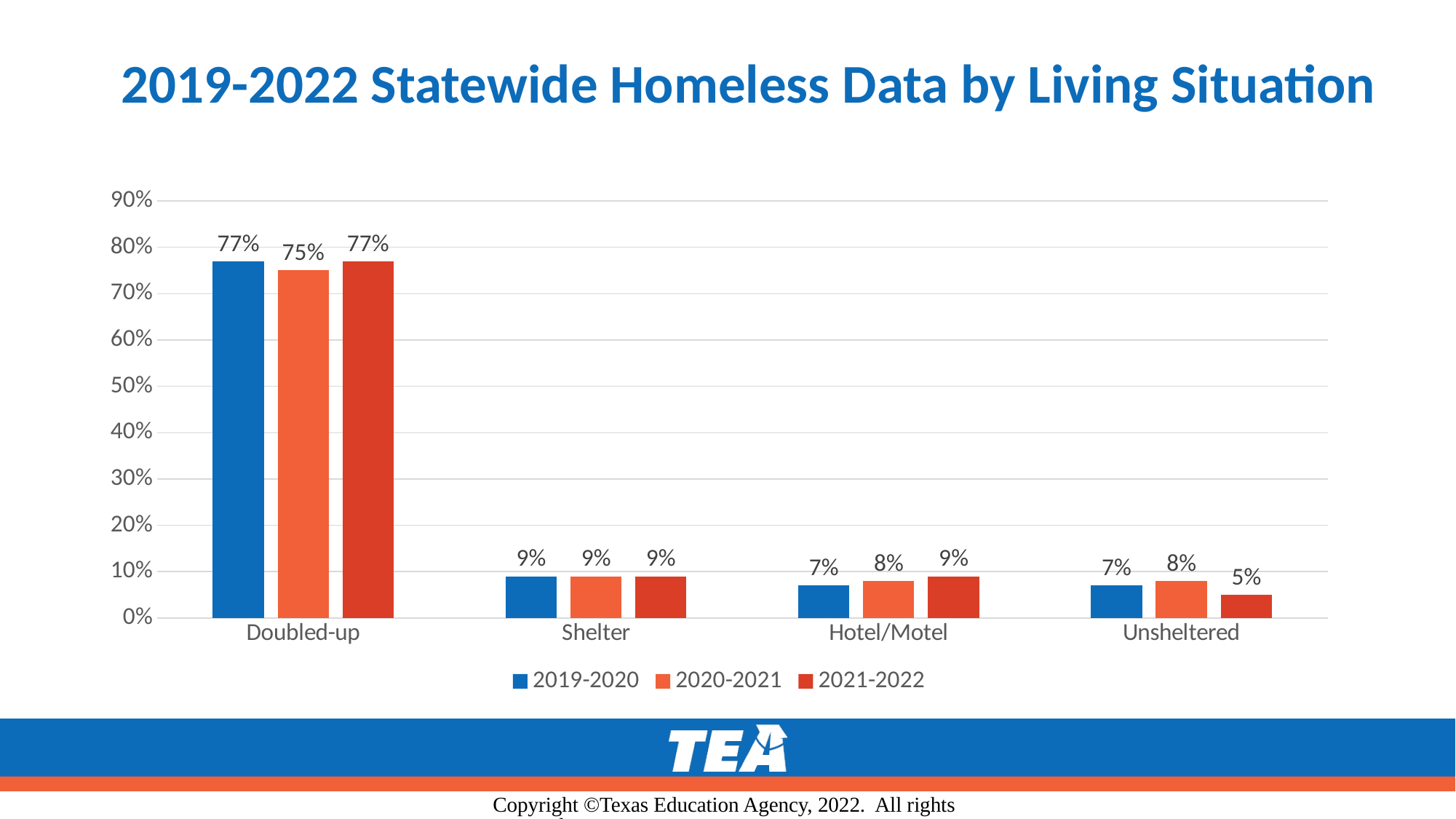
Which living situation has the lowest value in the 2021-2022 series? Unsheltered What is the value for Doubled-up in the 2020-2021 series? 75% How many living situation categories are shown on the x axis? 4 What kind of chart is shown on the slide? bar chart What is the title of the chart? 2019-2022 Statewide Homeless Data by Living Situation How many series does the legend list? 3 Which living situation has the highest value in the 2019-2020 series? Doubled-up What is the value for Hotel/Motel in the 2019-2020 series? 7% What is the value for Unsheltered in the 2021-2022 series? 5% What is the difference between the Doubled-up value and the Shelter value in the 2021-2022 series? 68% Is the value for Doubled-up in the 2019-2020 series greater or less than 70%? greater Which is larger for Unsheltered: the 2020-2021 value or the 2021-2022 value? 2020-2021